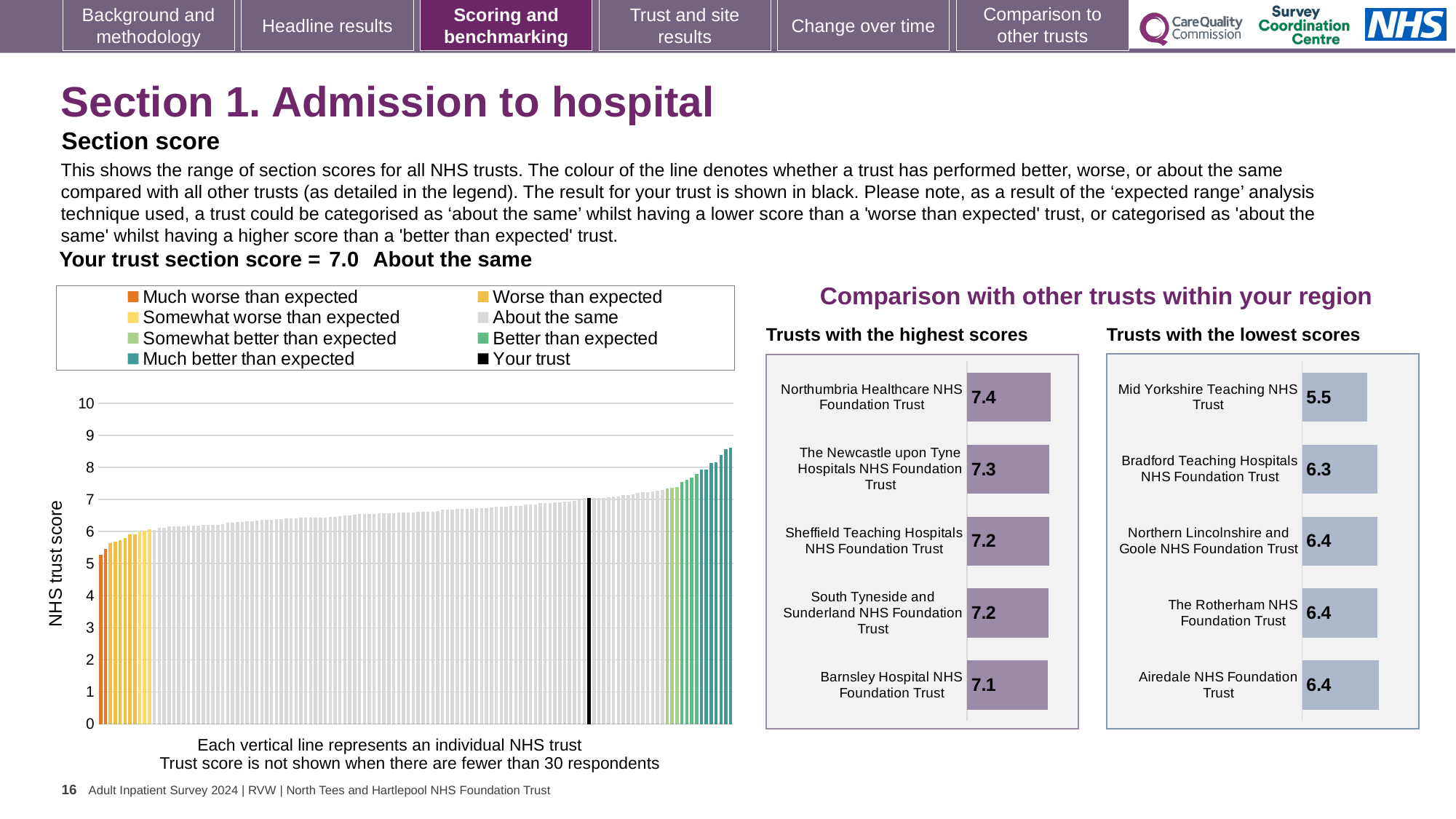
In the 'Trusts with the lowest scores' chart, which trust has the lowest score? Mid Yorkshire Teaching NHS Trust In the 'Trusts with the highest scores' chart, what is the difference between the scores of Northumbria Healthcare NHS Foundation Trust and Barnsley Hospital NHS Foundation Trust? 0.3 How many entries does the legend of the large chart on the left list? 8 In the 'Trusts with the lowest scores' chart, what is the difference between the scores of Bradford Teaching Hospitals NHS Foundation Trust and Mid Yorkshire Teaching NHS Trust? 0.8 In the 'Trusts with the highest scores' chart, what is the score for Barnsley Hospital NHS Foundation Trust? 7.1 In the 'Trusts with the highest scores' chart, what is the score for Northumbria Healthcare NHS Foundation Trust? 7.4 In the 'Trusts with the lowest scores' chart, what is the score for Mid Yorkshire Teaching NHS Trust? 5.5 In the 'Trusts with the highest scores' chart, which trust has the highest score? Northumbria Healthcare NHS Foundation Trust How many trusts are shown in the 'Trusts with the highest scores' chart? 5 In the large chart on the left showing all NHS trusts, what is the section score for your trust (the black bar)? 7.0 In the 'Trusts with the lowest scores' chart, which has the higher score: Mid Yorkshire Teaching NHS Trust or Bradford Teaching Hospitals NHS Foundation Trust? Bradford Teaching Hospitals NHS Foundation Trust In the large chart on the left showing all NHS trusts, is the value of the highest bar greater or less than 8? greater